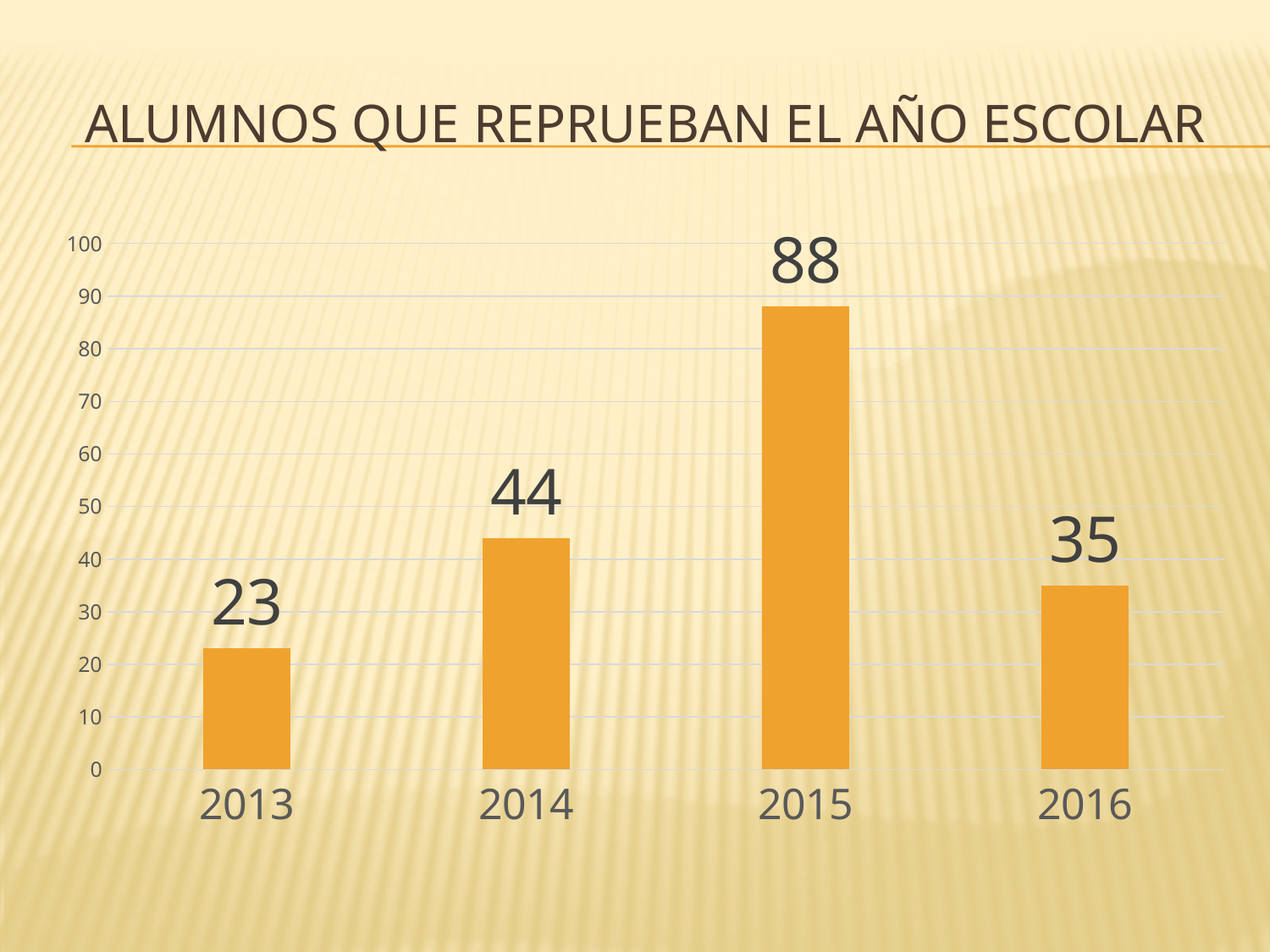
What is the value for 2013? 23 How many years are shown on the chart? 4 Which year has the lowest value? 2013 What is the value for 2014? 44 What is the value for 2015? 88 What kind of chart is shown on the slide? Bar chart Which year has the highest value? 2015 What is the title of the slide? ALUMNOS QUE REPRUEBAN EL AÑO ESCOLAR What is the difference between the values for 2016 and 2013? 12 Which is larger, the value for 2014 or the value for 2016? 2014 What is the value for 2016? 35 What is the difference between the values for 2015 and 2014? 44